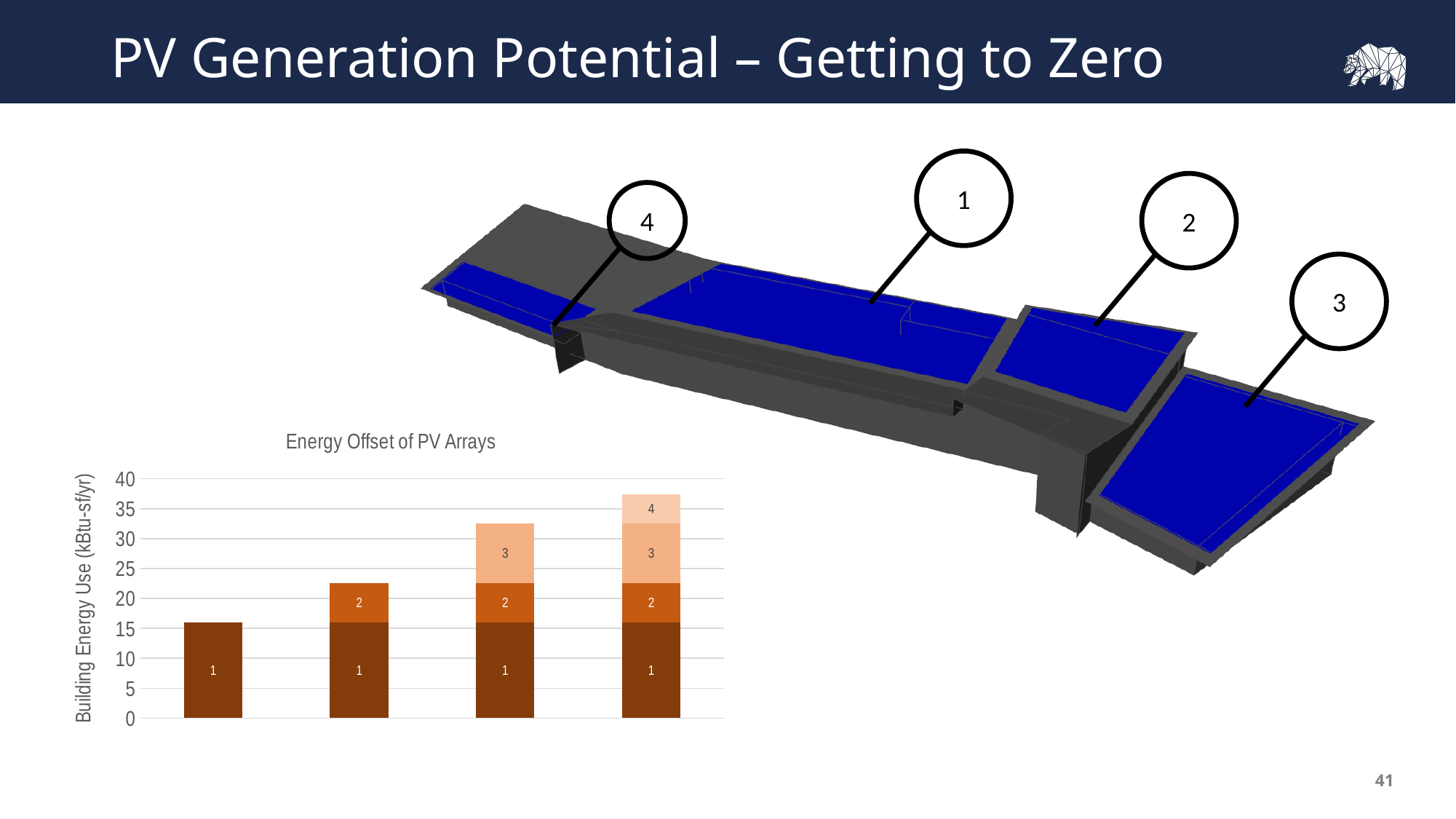
What kind of chart is shown on the slide? Stacked bar chart What is the title of the chart on the slide? Energy Offset of PV Arrays Is the total of the rightmost bar greater or less than 35? greater Is the total of the second bar from the left larger or smaller than the total of the third bar from the left? Smaller Which bar in the chart is the shortest? The leftmost bar What is the label of the vertical axis of the chart? Building Energy Use (kBtu-sf/yr) How many segments make up the rightmost bar in the chart? 4 How many bars are plotted in the chart? 4 Is the total of the third bar from the left greater or less than 30? greater Do the bar totals rise or fall from left to right across the chart? Rise Which bar in the chart is the tallest? The rightmost bar Is the total of the leftmost bar greater or less than 20? less